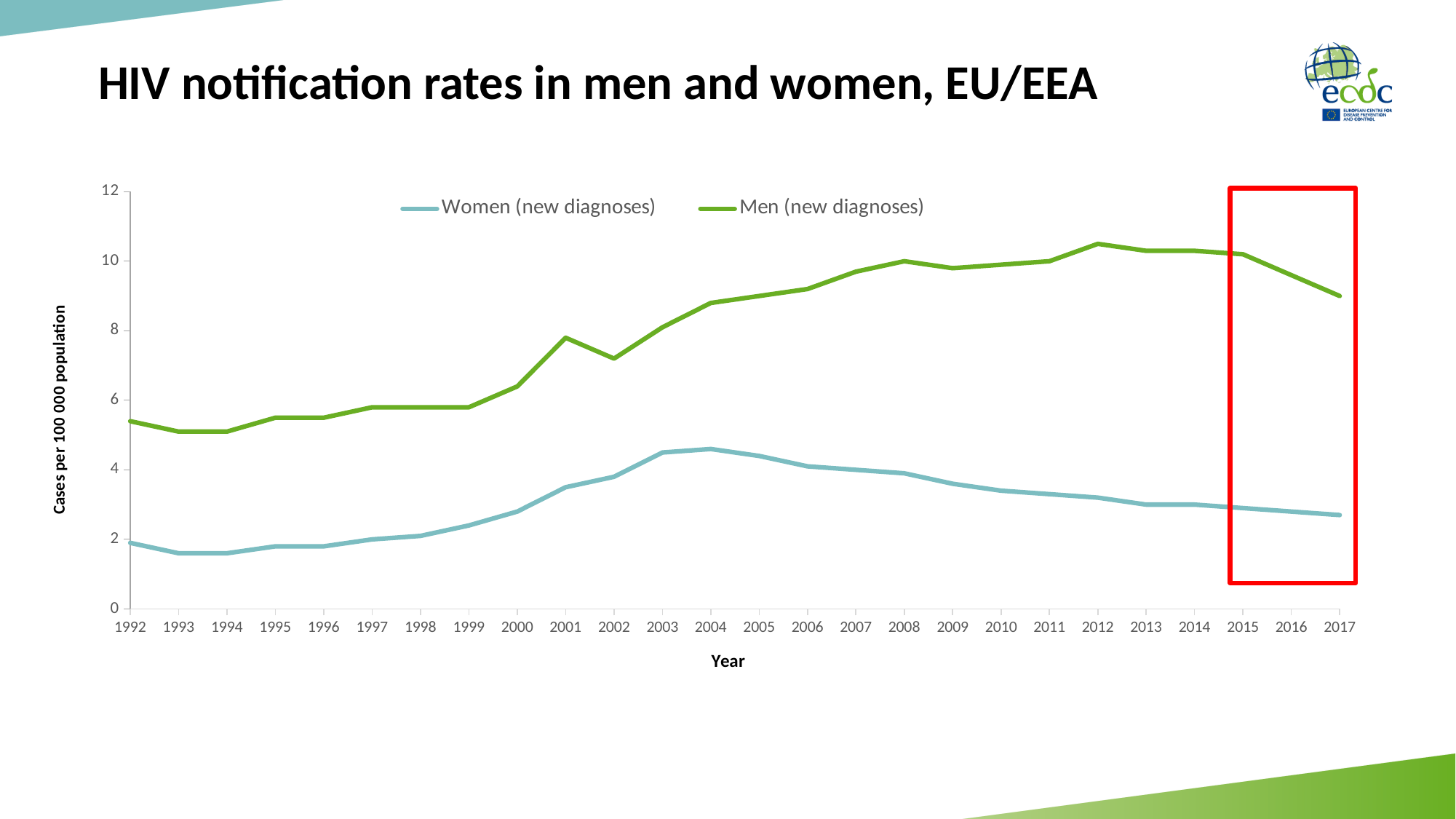
What is the label of the y axis? Cases per 100 000 population Does the Women (new diagnoses) line rise or fall from 2004 to 2017? fall Is the value for Women (new diagnoses) in 2004 greater or less than 4? greater In which year does the Men (new diagnoses) line reach its highest value? 2012 How many series does the legend list? 2 How many years are plotted along the x axis? 26 Is the value for Men (new diagnoses) in 2017 greater or less than 10? less Is the value for Men (new diagnoses) in 2012 greater or less than 10? greater What kind of chart is shown on the slide? line chart In 2010, which series has the higher value, Men (new diagnoses) or Women (new diagnoses)? Men (new diagnoses)